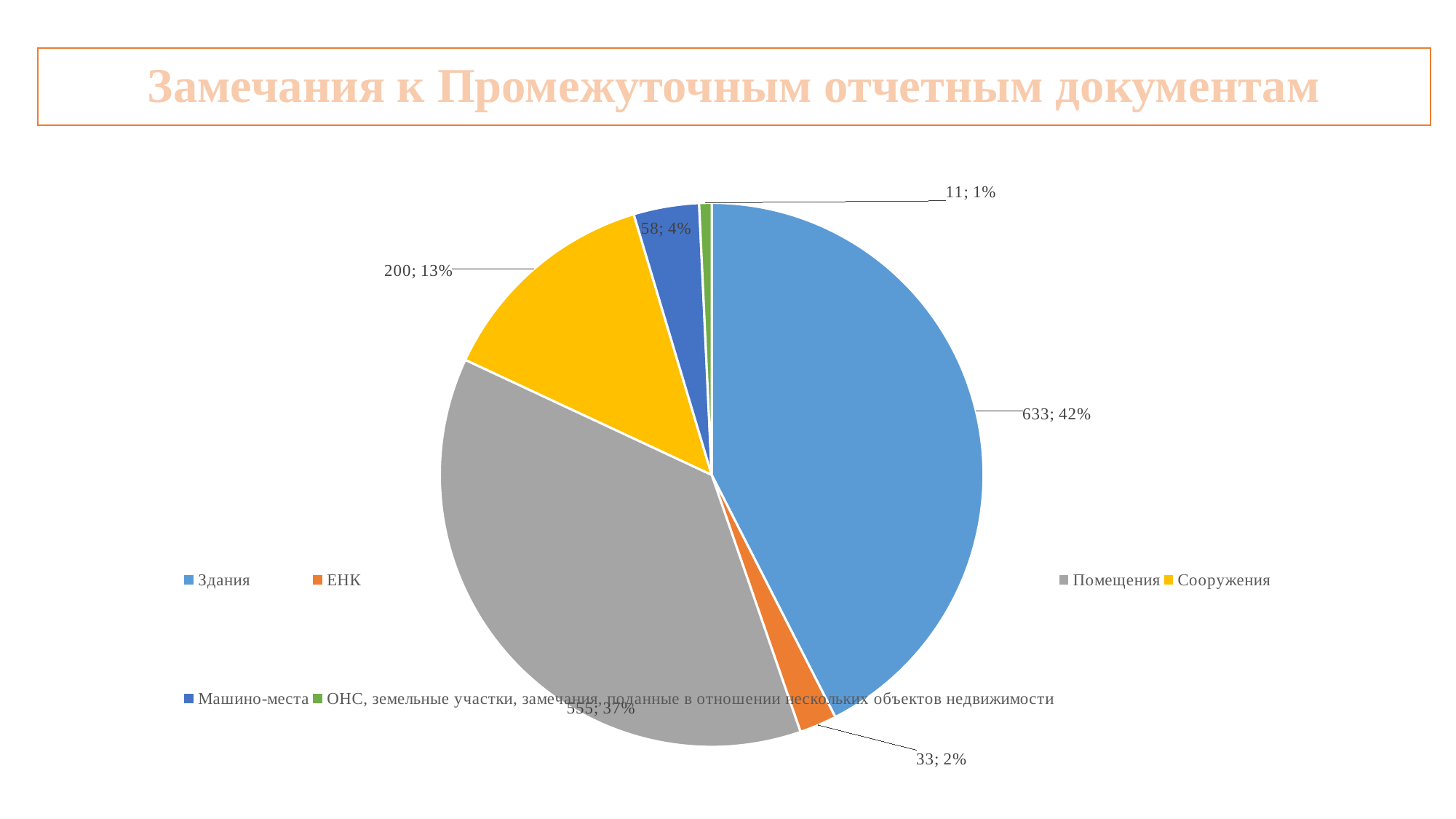
How many categories does the legend list? 6 What is the value for Помещения? 555 What share of the pie does Помещения represent? 37% What is the value for ЕНК? 33 What is the value for Машино-места? 58 What is the value for Сооружения? 200 What is the difference between the values for Здания and Помещения? 78 What is the value for Здания? 633 Which is larger, the value for Сооружения or the value for Машино-места? Сооружения Which category has the smallest slice of the pie? ОНС, земельные участки, замечания, поданные в отношении нескольких объектов недвижимости Which category has the largest slice of the pie? Здания What kind of chart is shown on the slide? pie chart